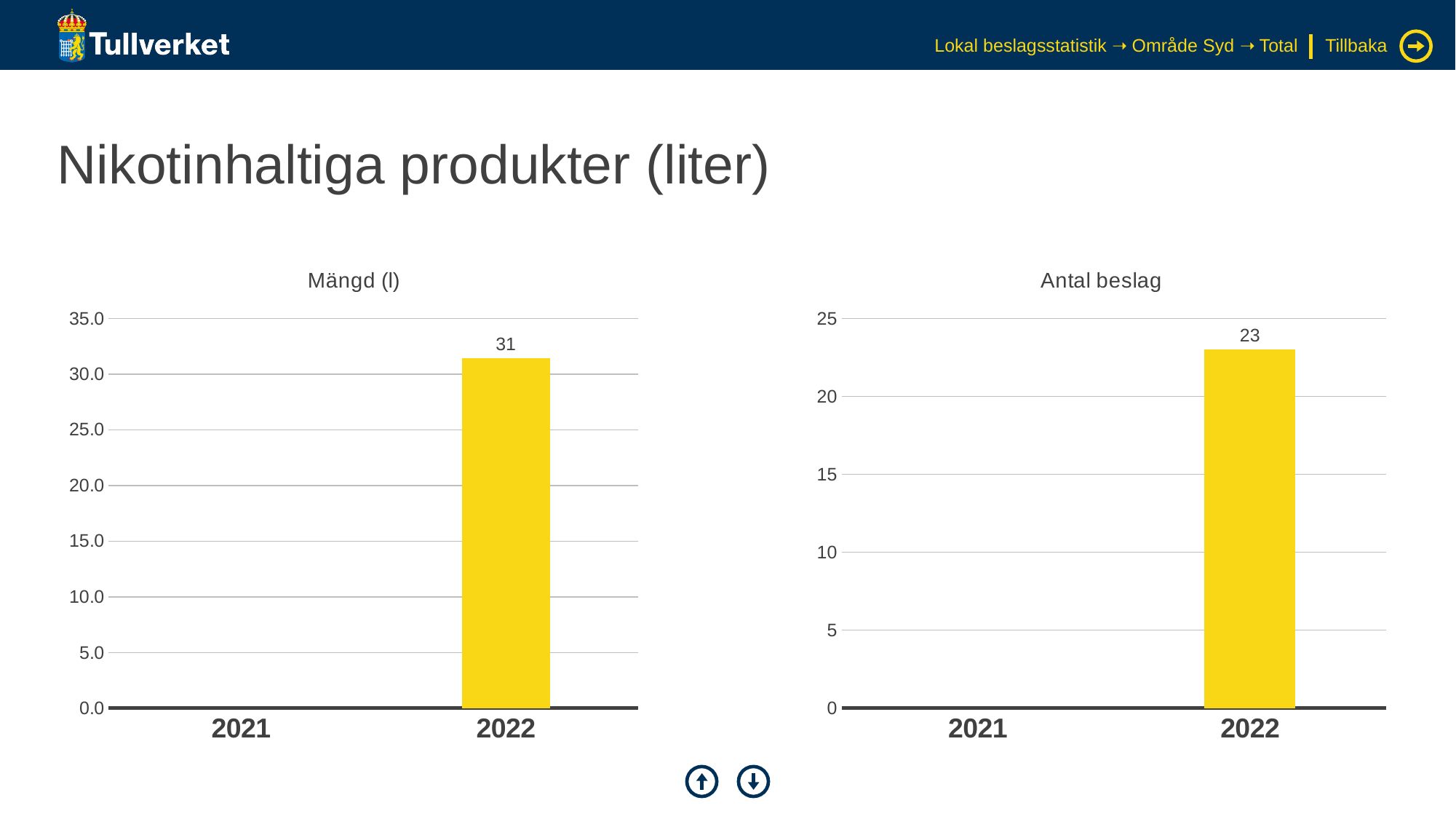
What kind of chart is the "Antal beslag" chart on the right? bar chart In the "Antal beslag" chart, which year has the highest value? 2022 How many categories are shown on the x axis of the "Mängd (l)" chart? 2 What colour are the bars in the "Mängd (l)" chart? yellow How many categories are shown on the x axis of the "Antal beslag" chart? 2 In the "Antal beslag" chart, is the value for 2022 greater or less than 25? less In the "Mängd (l)" chart, is the value for 2022 greater or less than 30.0? greater In the "Mängd (l)" chart, which year has the highest value? 2022 What kind of chart is the "Mängd (l)" chart on the left? bar chart In the chart titled "Mängd (l)", what is the value for 2022? 31 In the chart titled "Antal beslag", what is the value for 2022? 23 What is the title of the chart on the right side of the slide? Antal beslag